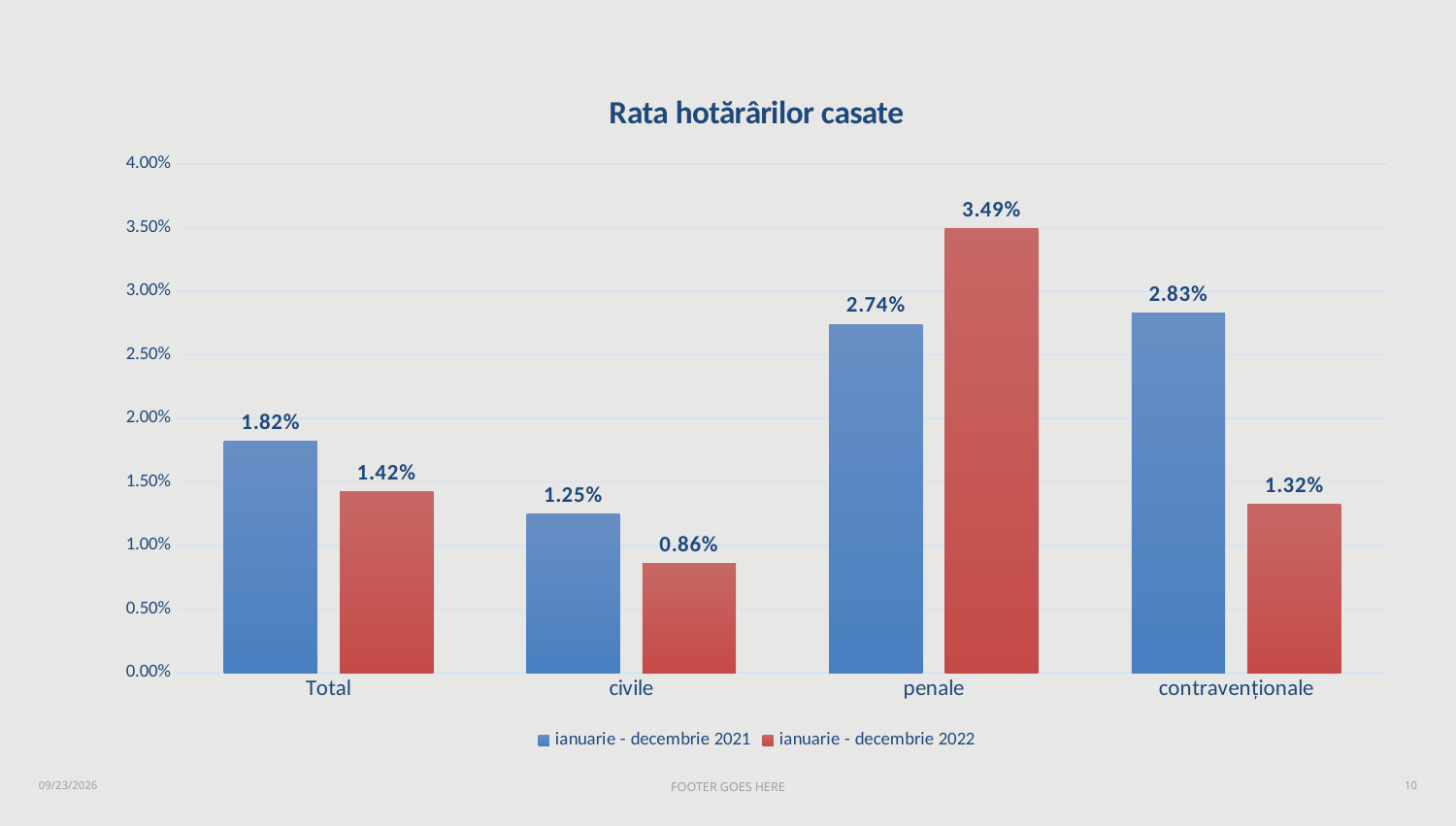
What is the title of the chart? Rata hotărârilor casate How many categories are shown on the x axis? 4 What kind of chart is shown on the slide? bar chart What is the value for 'civile' in the 'ianuarie - decembrie 2022' series? 0.86% What is the difference between the 2021 and 2022 values for 'contravenționale'? 1.51% Is the value for 'civile' in the 'ianuarie - decembrie 2021' series greater or less than 1.50%? less What is the value for 'Total' in the 'ianuarie - decembrie 2021' series? 1.82% Which is larger for 'penale': the 'ianuarie - decembrie 2021' value or the 'ianuarie - decembrie 2022' value? ianuarie - decembrie 2022 Which category has the highest value in the 'ianuarie - decembrie 2021' series? contravenționale Which category has the lowest value in the 'ianuarie - decembrie 2022' series? civile What is the value for 'penale' in the 'ianuarie - decembrie 2022' series? 3.49% How many series does the legend list? 2